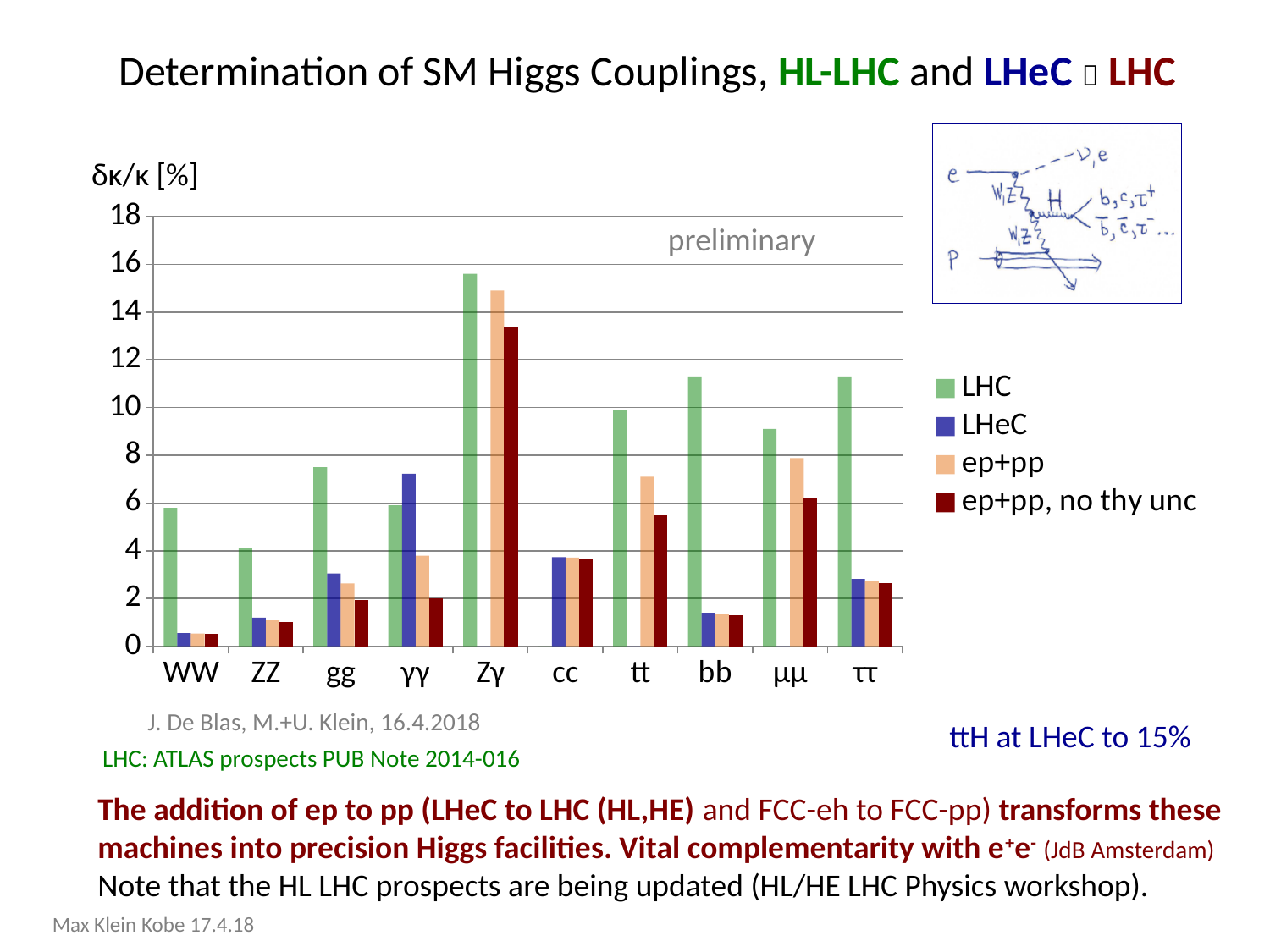
Which category has the highest LHC value? Zγ What kind of chart is shown on the slide? bar chart Is the LHC value for bb greater or less than 10? greater Is the ep+pp, no thy unc value for μμ greater or less than 8? less Is the LHC value for Zγ greater or less than 14? greater How many categories are shown along the x axis of the chart? 10 How many series does the chart legend list? 4 Which category has the highest ep+pp value? Zγ What is the label on the y axis of the chart? δκ/κ [%] For WW, which is larger: the LHC value or the ep+pp value? LHC For γγ, which is larger: the LHC value or the LHeC value? LHeC